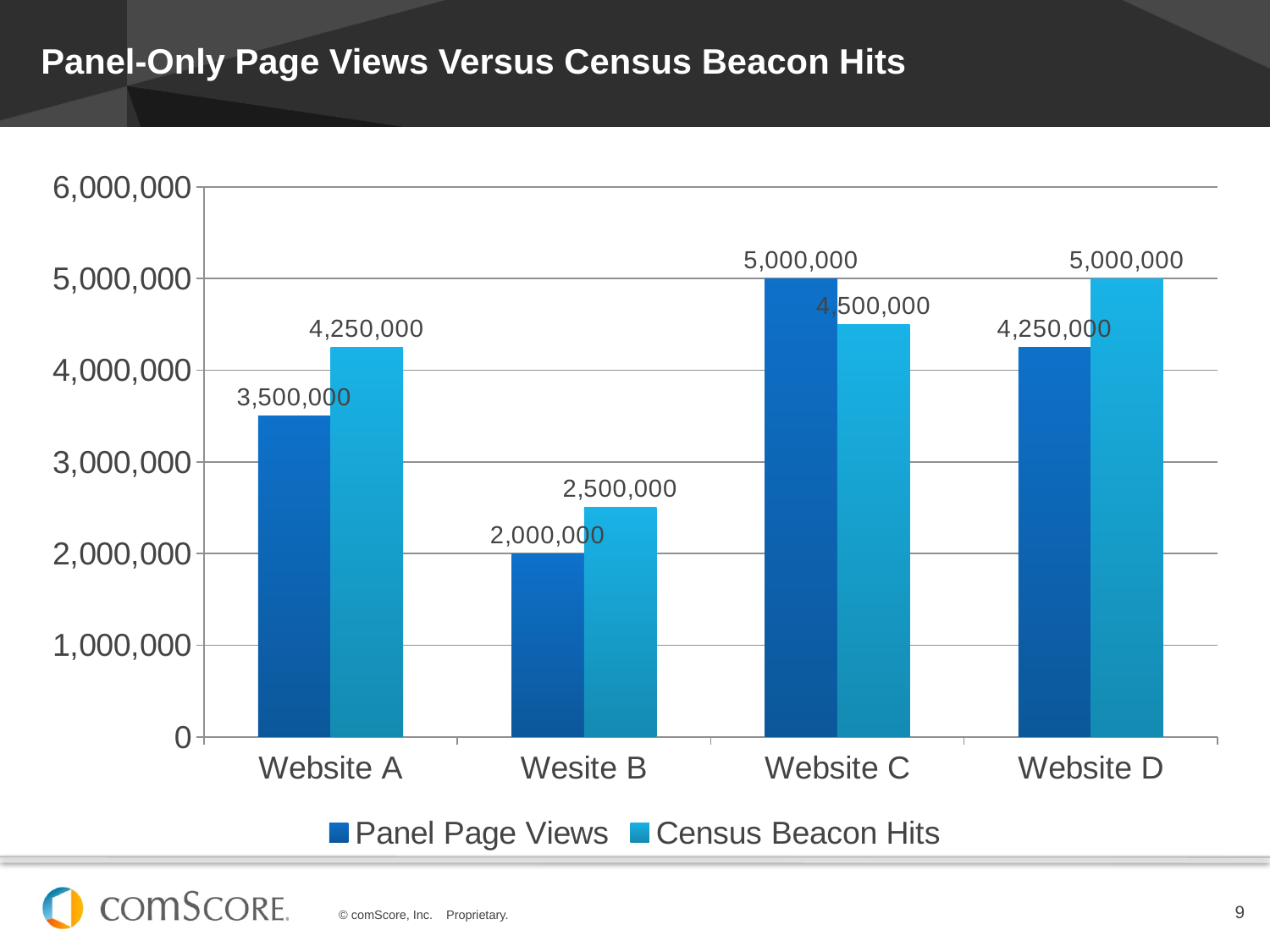
What is the title of the slide? Panel-Only Page Views Versus Census Beacon Hits How many websites are shown on the x axis? 4 For Website C, which is larger: Panel Page Views or Census Beacon Hits? Panel Page Views What kind of chart is shown on the slide? bar chart How many series does the legend list? 2 Which website has the highest Panel Page Views? Website C What is the Census Beacon Hits value for Wesite B? 2,500,000 What is the Census Beacon Hits value for Website D? 5,000,000 What is the Panel Page Views value for Website A? 3,500,000 Which website has the lowest Census Beacon Hits? Wesite B Is the Panel Page Views value for Wesite B greater or less than 3,000,000? less What is the difference between Census Beacon Hits and Panel Page Views for Website A? 750,000